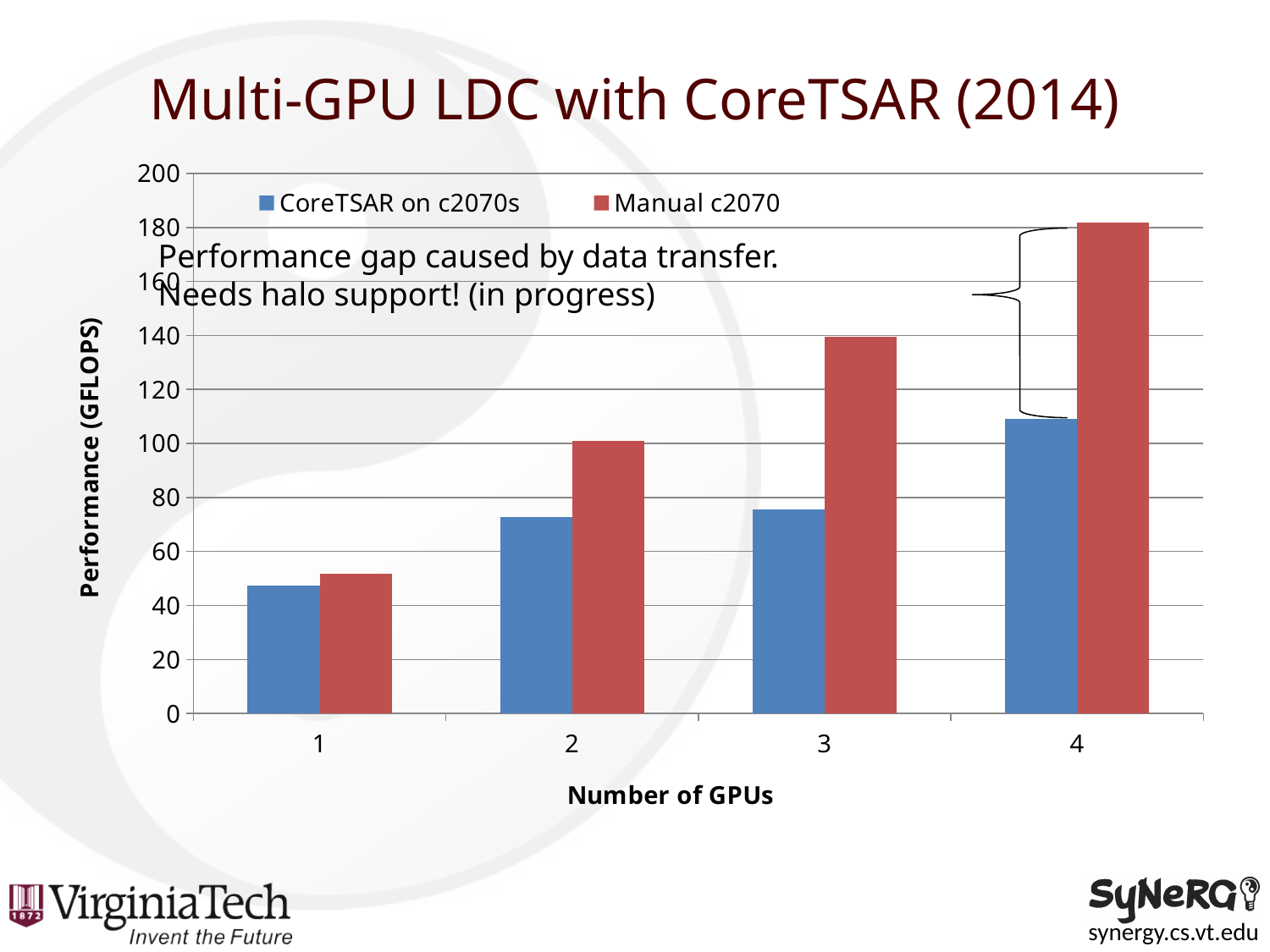
Is the CoreTSAR on c2070s value at 2 GPUs greater or less than 80? less At 3 GPUs, which series has the higher performance, CoreTSAR on c2070s or Manual c2070? Manual c2070 For which number of GPUs is the Manual c2070 performance highest? 4 How many series does the legend list? 2 Is the CoreTSAR on c2070s value at 1 GPU greater or less than 60? less What is the label of the y axis? Performance (GFLOPS) Is the Manual c2070 value at 4 GPUs greater or less than 160? greater Does the Manual c2070 performance rise or fall as the number of GPUs increases from 1 to 4? rise For which number of GPUs is the CoreTSAR on c2070s performance lowest? 1 How many GPU counts (categories) are shown on the x axis? 4 At 2 GPUs, which series has the higher performance, CoreTSAR on c2070s or Manual c2070? Manual c2070 What kind of chart is shown on the slide? bar chart